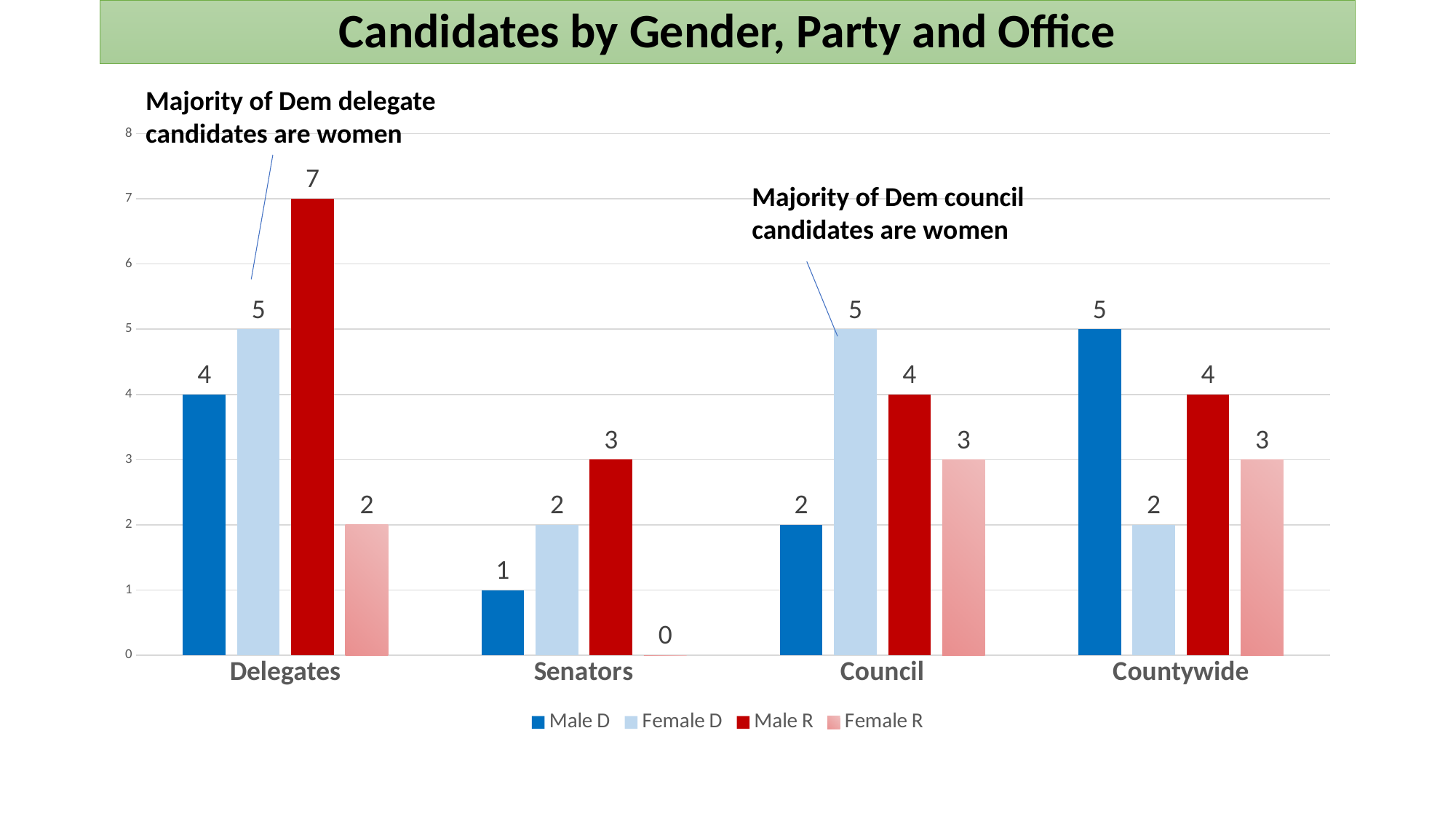
What is the value for Male D in the Countywide category? 5 What kind of chart is shown on the slide? Bar chart What is the value for Male R in the Delegates category? 7 What is the value for Female R in the Senators category? 0 How many categories are shown on the x axis? 4 Which category has the highest Male R value? Delegates What is the title of the chart? Candidates by Gender, Party and Office What is the difference between Male R and Female R in the Delegates category? 5 Which is larger in the Council category, Male D or Female D? Female D Which category has the lowest Male D value? Senators What is the value for Female D in the Council category? 5 How many series does the legend list? 4